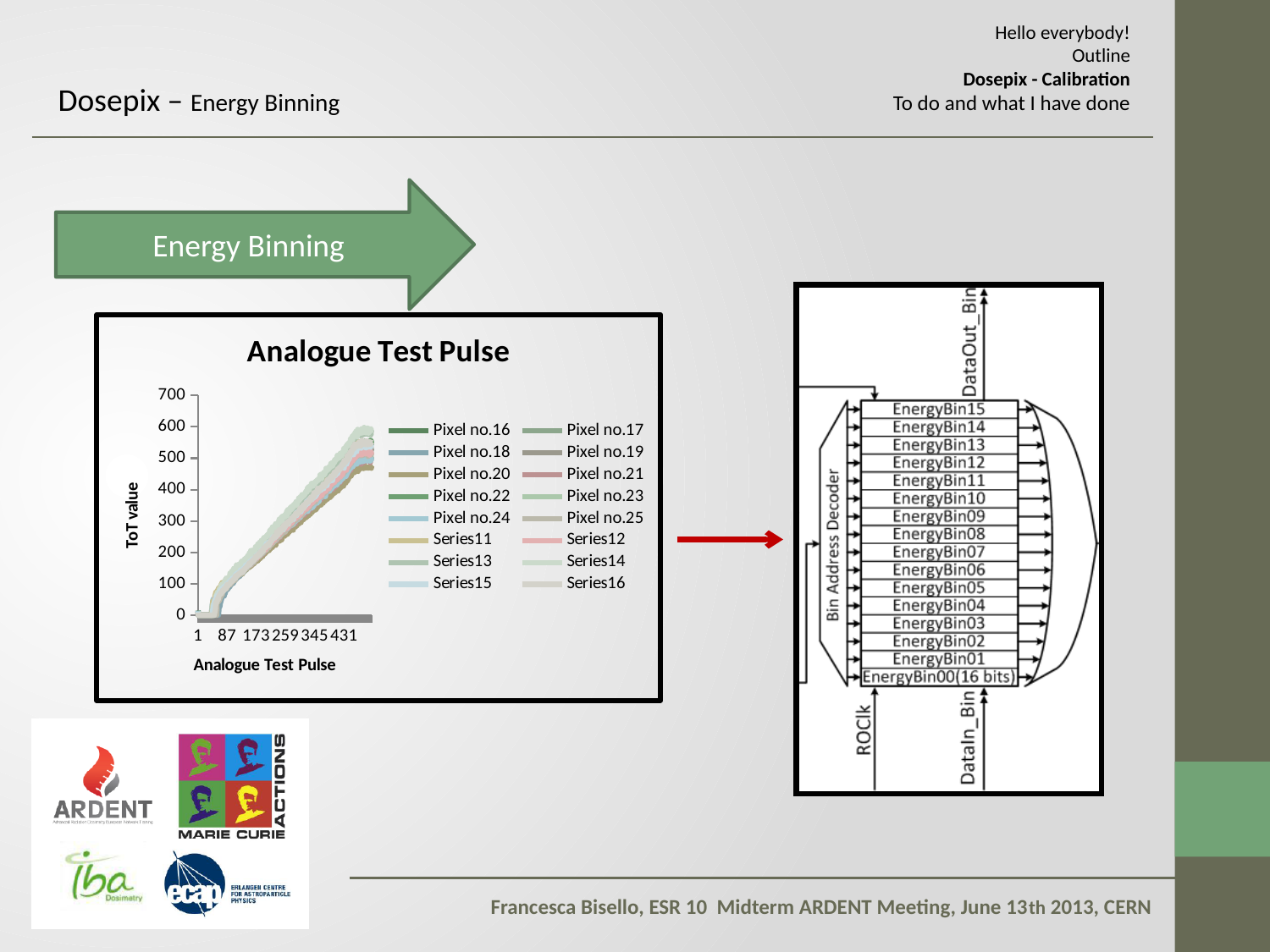
What is the last tick value shown on the x axis of the Analogue Test Pulse chart? 431 How many series does the legend of the Analogue Test Pulse chart list? 16 What is the title of the chart on the slide? Analogue Test Pulse Do the ToT values in the Analogue Test Pulse chart rise or fall as the analogue test pulse increases along the x axis? rise Is the highest ToT value reached by the lines in the Analogue Test Pulse chart greater or less than 400? greater What is the label of the y axis of the Analogue Test Pulse chart? ToT value What kind of chart is the Analogue Test Pulse chart? line chart What is the highest tick value shown on the y axis of the Analogue Test Pulse chart? 700